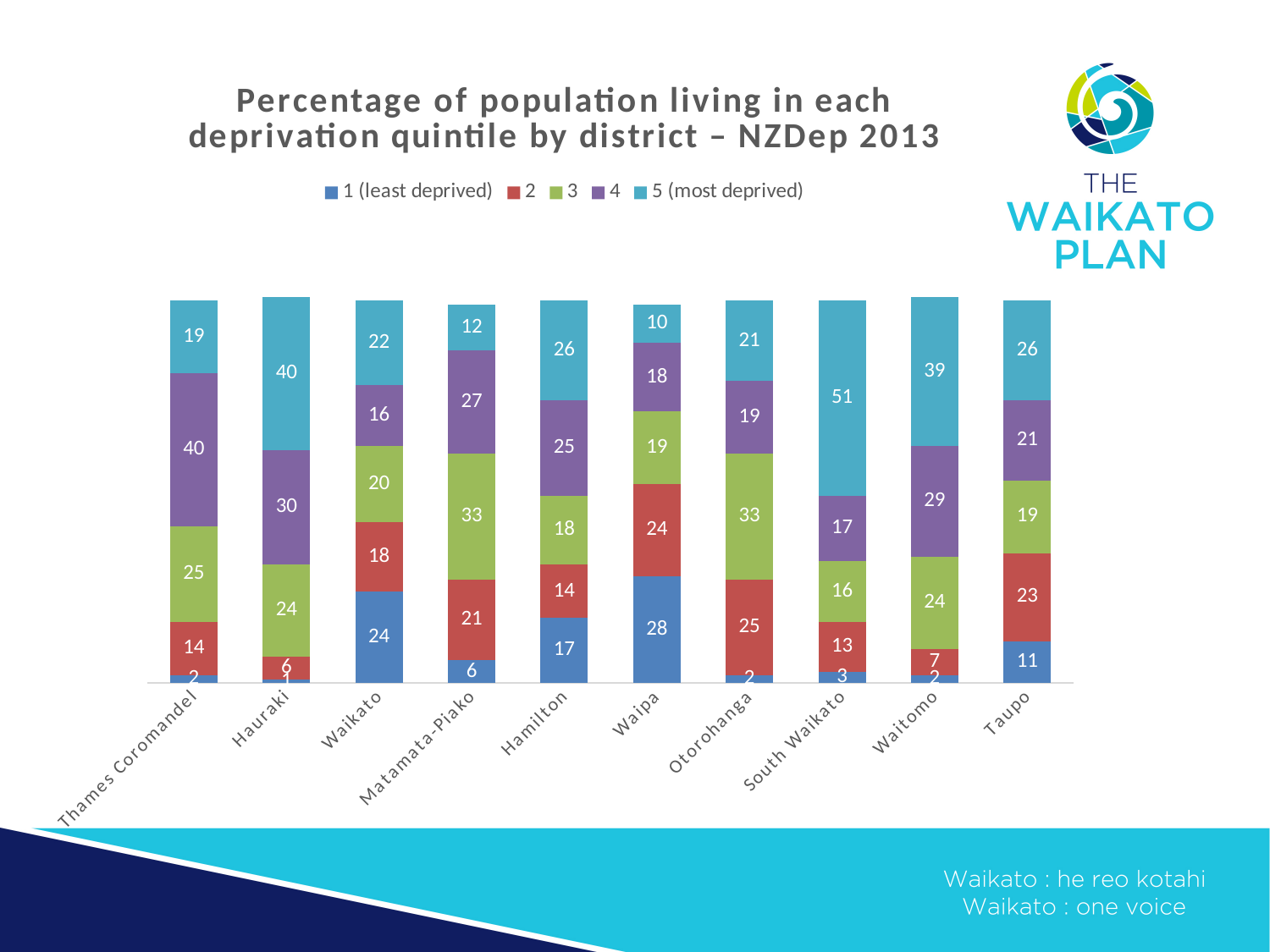
Which district has the highest percentage in quintile 1 (least deprived)? Waipa Which district has the highest percentage in quintile 5 (most deprived)? South Waikato How many series does the legend list? 5 Which district has a larger quintile 1 (least deprived) value, Waikato or Hamilton? Waikato What kind of chart is shown on the slide? Stacked bar chart How much larger is Hauraki's quintile 5 value than Thames Coromandel's quintile 5 value? 21 What is the value for quintile 3 in Matamata-Piako? 33 Which district has the lowest percentage in quintile 5 (most deprived)? Waipa What is the total of the stacked bar for Waikato? 100 How many districts are shown on the x axis? 10 What percentage of Waipa's population lives in quintile 1 (least deprived)? 28 What percentage of South Waikato's population lives in quintile 5 (most deprived)? 51